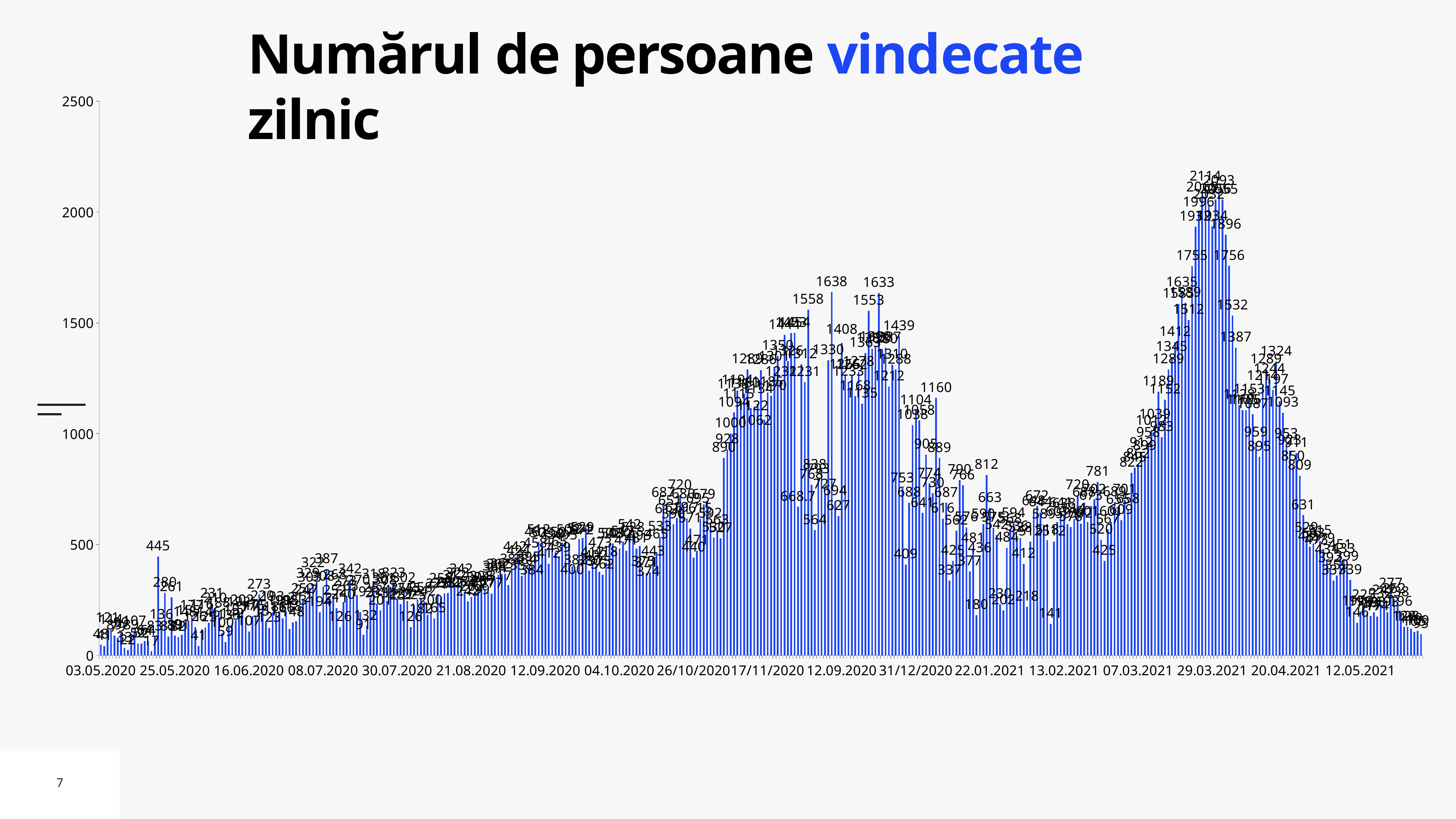
What is the value of the tallest bar in May 2020, the spike just before the 25.05.2020 label? 445 Near which x-axis date label does the highest bar of the chart occur? 29.03.2021 Do the values generally rise or fall between 29.03.2021 and 12.05.2021? fall What kind of chart is shown on the slide? bar chart Is the value of the first bar (03.05.2020) greater or less than 500? less Do the values generally rise or fall between 03.05.2020 and 12.09.2020? rise What is the maximum value shown on the y axis? 2500 What is the difference between the highest value (2114) and the November 2020 peak of 1638? 476 What is the title of the chart? Numărul de persoane vindecate zilnic Which is higher: the peak of 1638 in November 2020 or the peak of 2114 in late March 2021? the peak of 2114 in late March 2021 Is the tallest bar on the chart greater or less than 2000? greater What is the highest value labelled on the chart? 2114